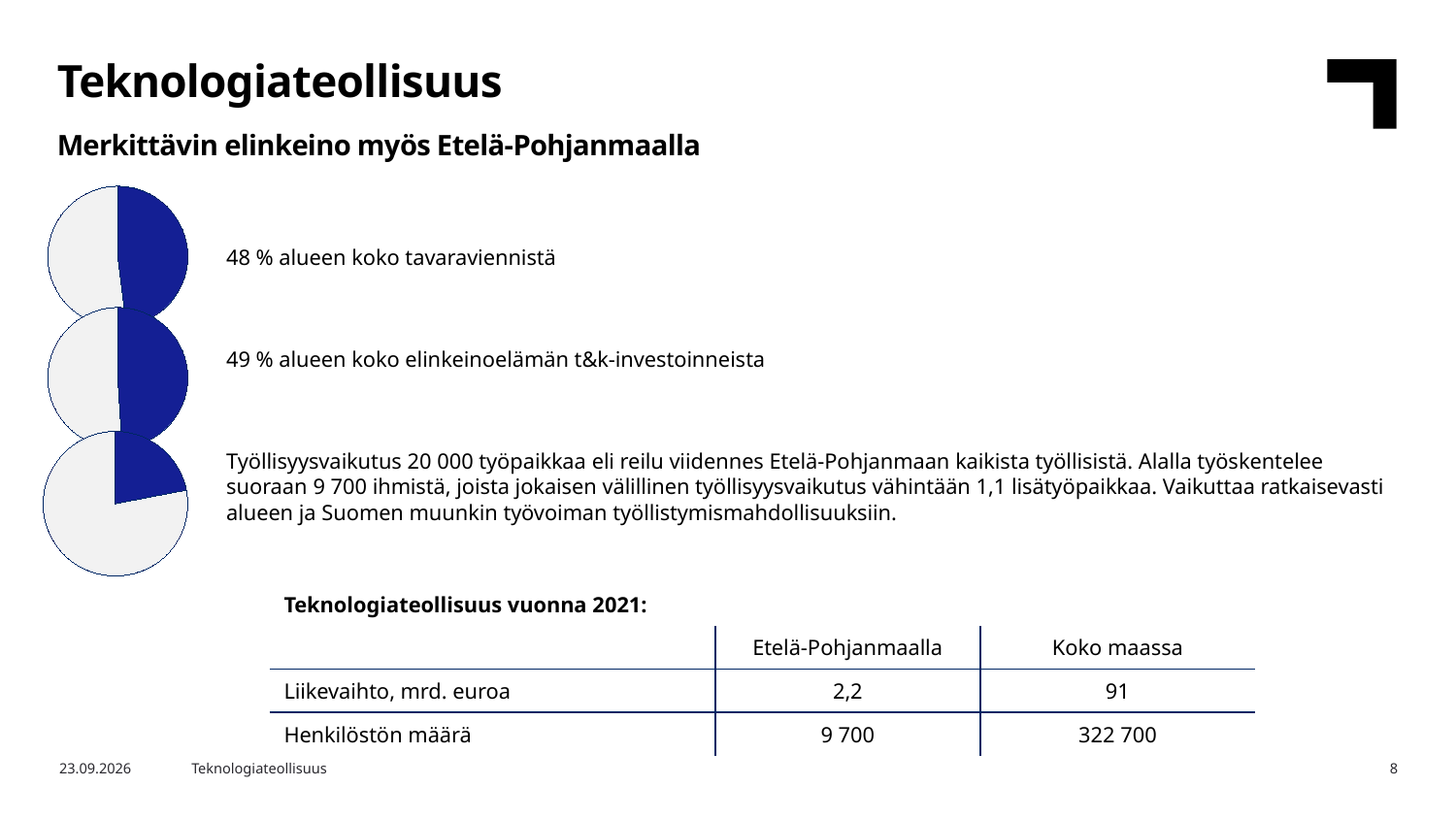
What does the blue slice of the top pie chart represent, according to the text beside it? 48 % alueen koko tavaraviennistä What kind of charts are shown on the left side of the slide? Pie charts What colour is used for the highlighted slice in each pie chart? Blue How many pie charts are on the slide? 3 Is the blue slice of the top pie chart larger or smaller than the blue slice of the bottom pie chart? larger Which of the three pie charts has the smallest highlighted (blue) slice? The bottom pie chart According to the text next to the top pie chart, what share of the region's total goods exports does the technology industry account for? 48 % Is the blue slice of the bottom pie chart greater or less than half of the pie? less According to the text next to the middle pie chart, what share of the region's business R&D investments does the technology industry account for? 49 %